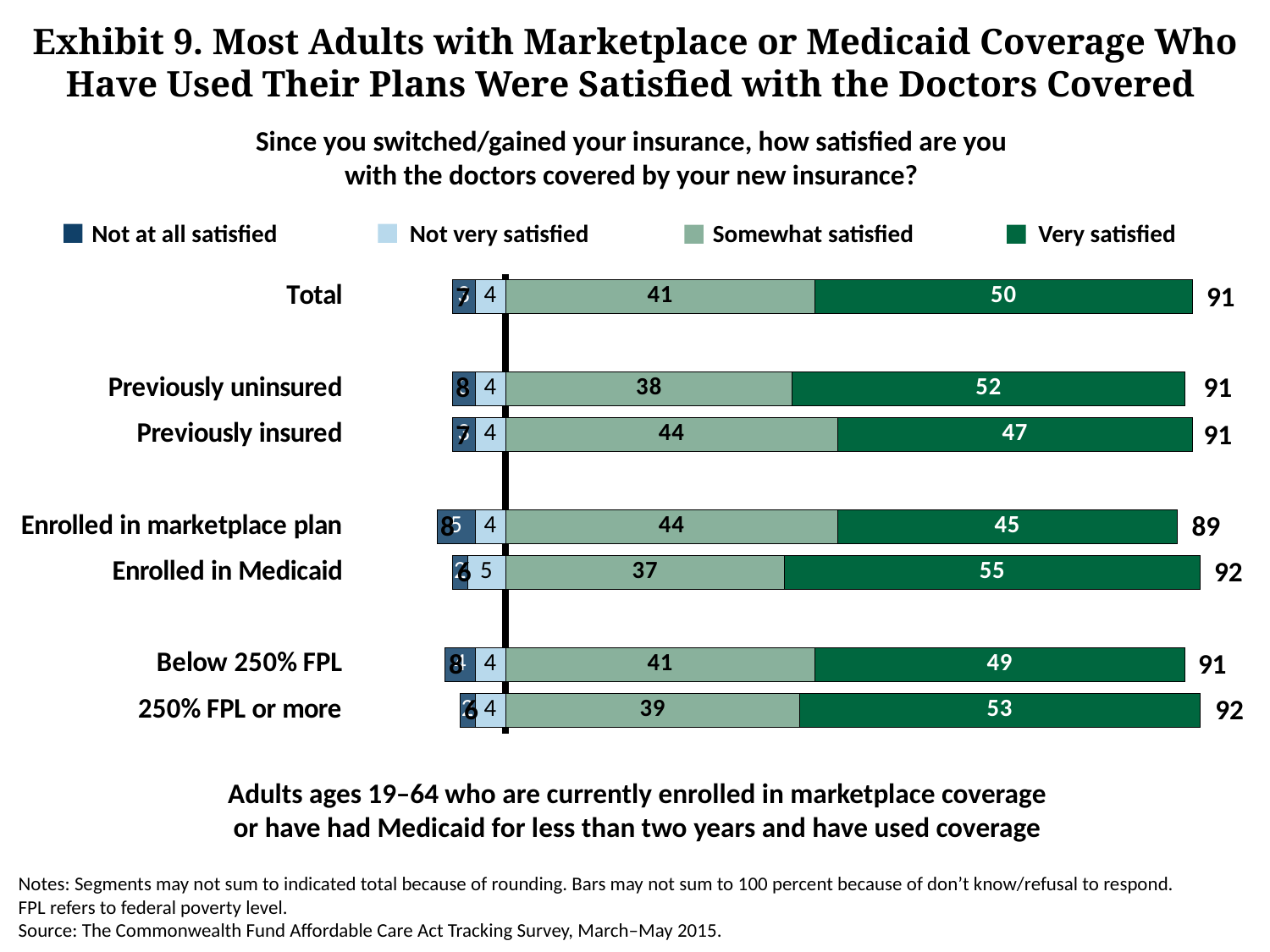
What is the value for Not very satisfied for Enrolled in Medicaid? 5 What colour represents Very satisfied in the legend? Dark green What is the value for Very satisfied for Enrolled in Medicaid? 55 Which has the larger Somewhat satisfied value, Previously insured or Enrolled in Medicaid? Previously insured How many categories are shown on the chart? 7 How many series does the legend list? 4 What is the difference between the Very satisfied values for Previously uninsured and Previously insured? 5 What is the value for Somewhat satisfied for Previously uninsured? 38 What kind of chart is shown on the slide? Stacked bar chart Which category has the lowest Very satisfied value? Enrolled in marketplace plan Which category has the highest Very satisfied value? Enrolled in Medicaid What number is printed at the right end of the bar for Enrolled in marketplace plan? 89